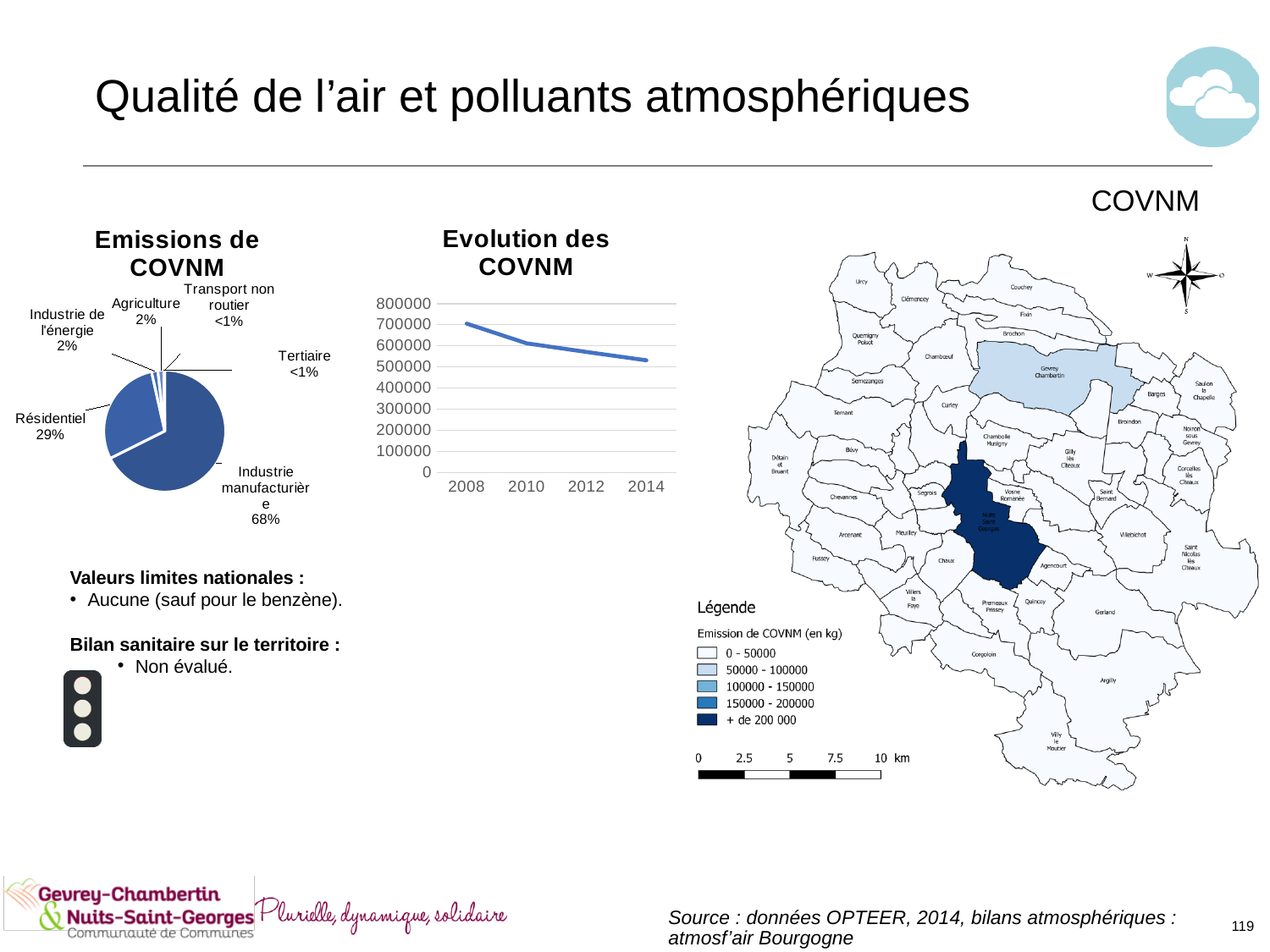
What kind of chart is 'Emissions de COVNM'? Pie chart How many sectors are shown in the pie chart 'Emissions de COVNM'? 6 In the pie chart 'Emissions de COVNM', which sector has the largest share? Industrie manufacturière In the pie chart 'Emissions de COVNM', what share is attributed to Industrie manufacturière? 68% In the pie chart 'Emissions de COVNM', what share is attributed to Résidentiel? 29% In the pie chart 'Emissions de COVNM', what share is attributed to Agriculture? 2% In the pie chart 'Emissions de COVNM', what is the difference in percentage points between Industrie manufacturière and Résidentiel? 39 percentage points What kind of chart is 'Evolution des COVNM'? Line chart In the chart 'Evolution des COVNM', is the value for 2008 greater or less than 600000? greater In the pie chart 'Emissions de COVNM', which has the larger share, Résidentiel or Agriculture? Résidentiel In the chart 'Evolution des COVNM', do the values rise or fall from 2008 to 2014? Fall In the chart 'Evolution des COVNM', is the value for 2014 greater or less than 600000? less